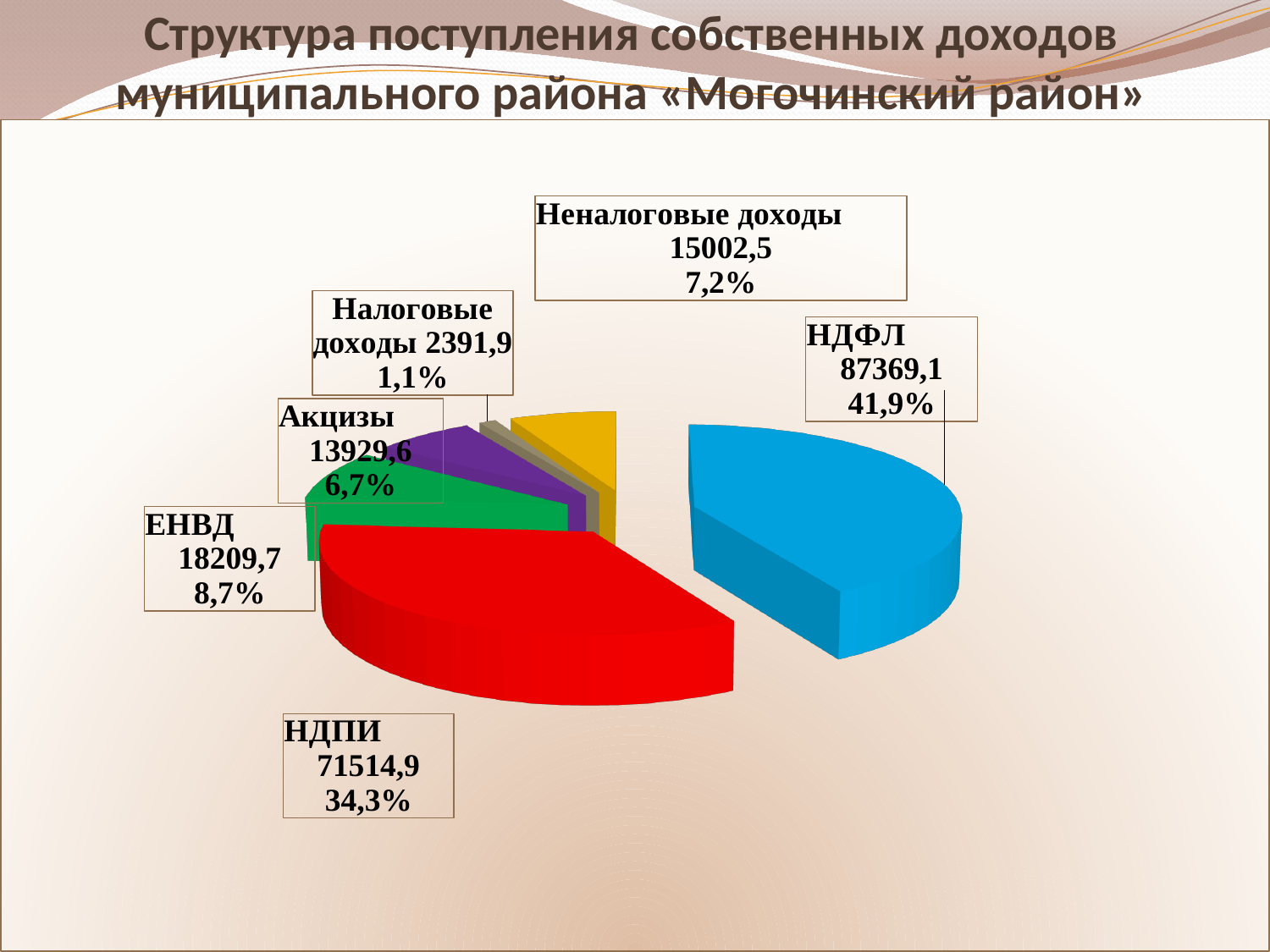
What is the difference in percentage points between the shares of НДФЛ and НДПИ? 7,6 What is the value shown for НДФЛ? 87369,1 What is the value shown for Неналоговые доходы? 15002,5 What kind of chart is shown on the slide? pie chart Which is larger, the value for ЕНВД or the value for Акцизы? ЕНВД Which category has the smallest share of the pie? Налоговые доходы What is the value shown for ЕНВД? 18209,7 What colour is the slice for НДПИ? red Which category has the largest share of the pie? НДФЛ How many slices does the pie chart have? 6 What percentage is shown for Акцизы? 6,7% What share of the pie does НДПИ represent? 34,3%